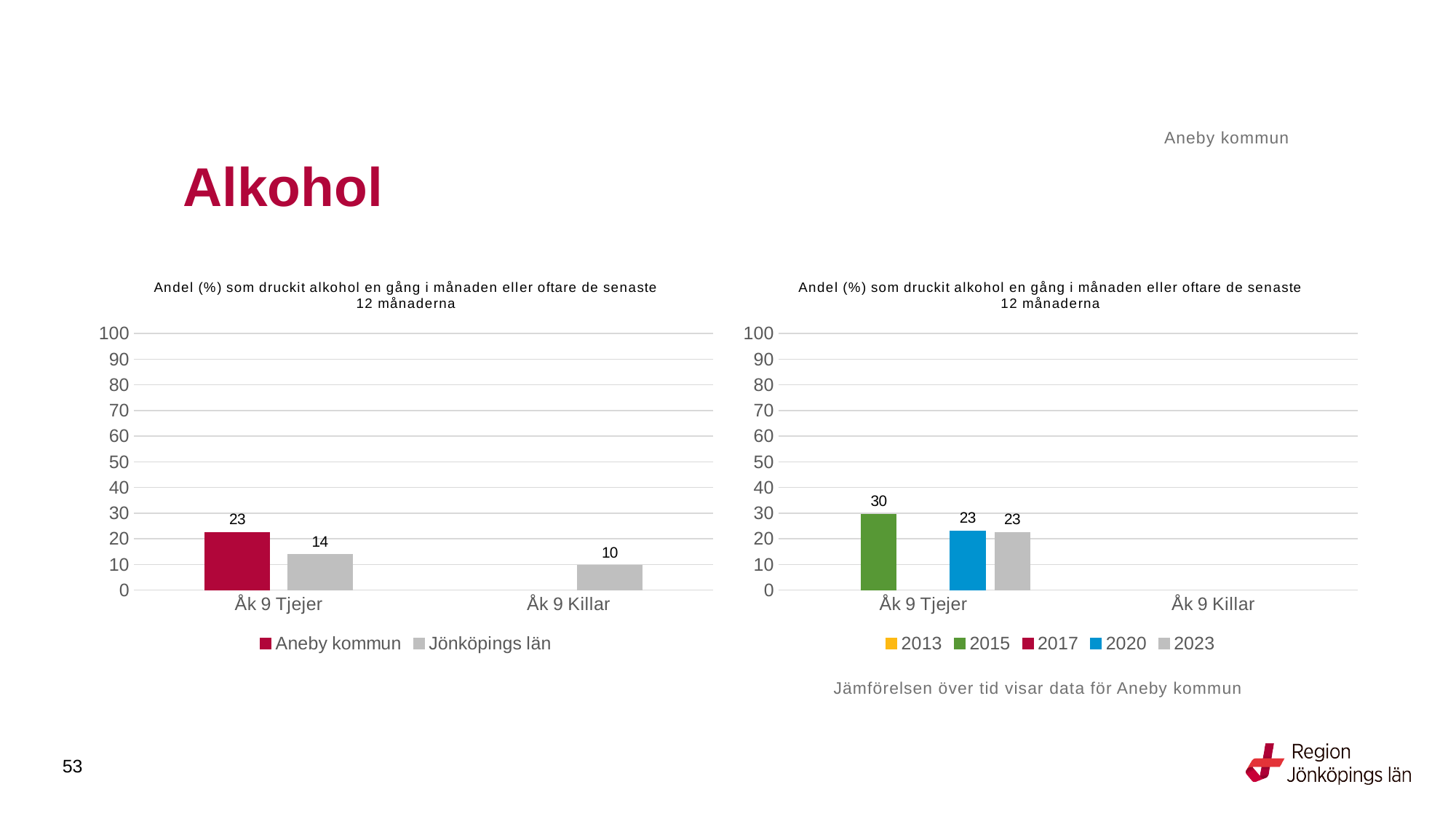
In the left chart, what is the difference between Aneby kommun and Jönköpings län for Åk 9 Tjejer? 9 In the right chart, how many series does the legend list? 5 In the right chart, which year has the highest value for Åk 9 Tjejer? 2015 In the left chart, how many series does the legend list? 2 In the left chart, what is the value for Jönköpings län for Åk 9 Tjejer? 14 In the right chart, what is the value for 2020 for Åk 9 Tjejer? 23 In the right chart, what is the value for 2015 for Åk 9 Tjejer? 30 In the right chart, what is the difference between the 2015 and 2023 values for Åk 9 Tjejer? 7 What kind of chart is the left chart? Bar chart In the left chart, what is the value for Jönköpings län for Åk 9 Killar? 10 In the left chart, what is the value for Aneby kommun for Åk 9 Tjejer? 23 In the left chart, which is larger for Åk 9 Tjejer: Aneby kommun or Jönköpings län? Aneby kommun